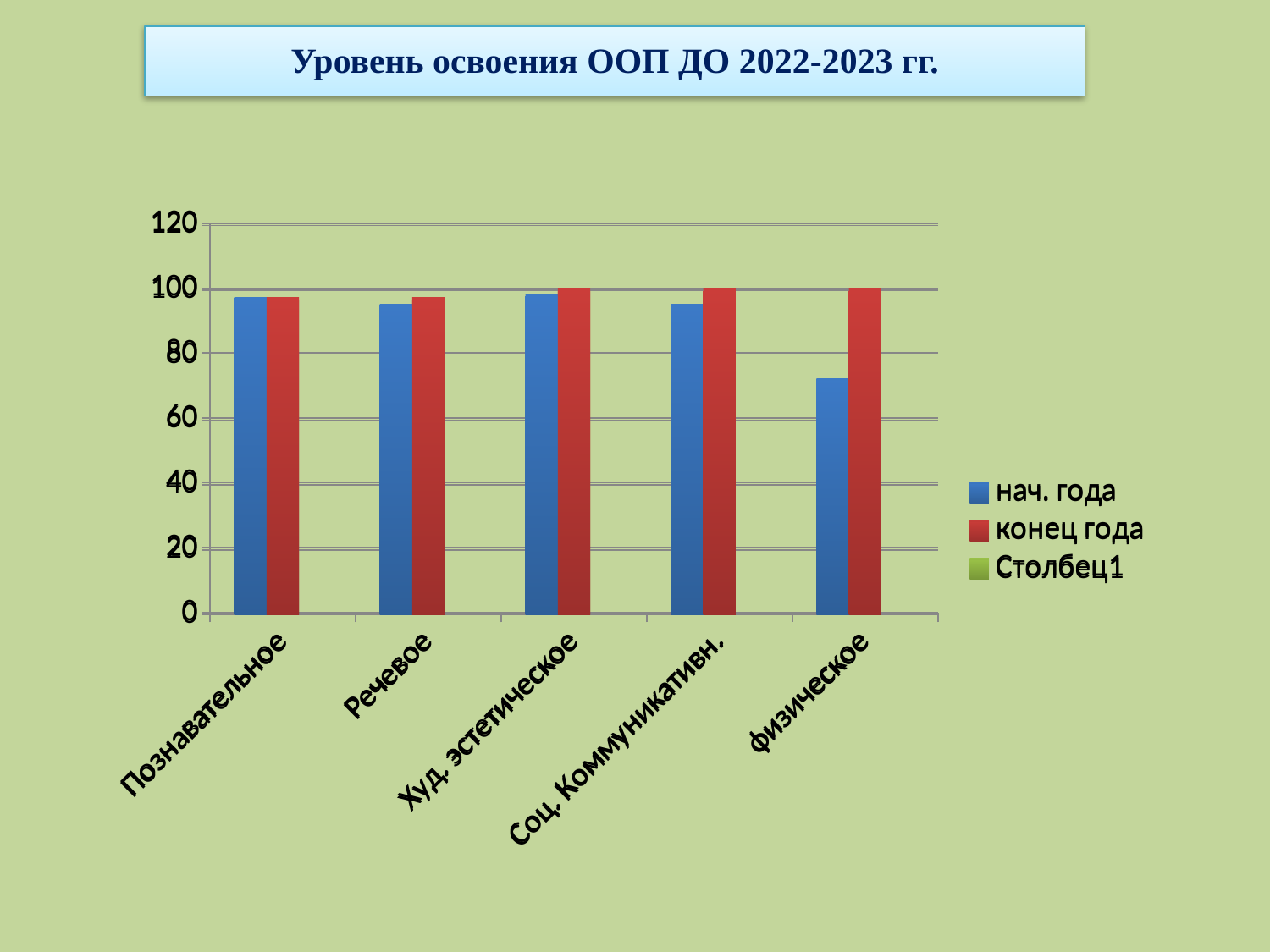
Which series is shown in red in the legend? конец года Which category has the lowest value for нач. года? физическое Is the value for Познавательное in the нач. года series greater or less than 80? greater What is the title of the chart? Уровень освоения ООП ДО 2022-2023 гг. Is the value for физическое in the конец года series greater or less than 80? greater Is the value for физическое in the нач. года series greater or less than 80? less For физическое, which is larger: the нач. года value or the конец года value? конец года How many categories are shown on the x axis of the chart? 5 How many series does the legend list? 3 What kind of chart is shown on the slide? bar chart For Соц. Коммуникативн., which is larger: the нач. года value or the конец года value? конец года